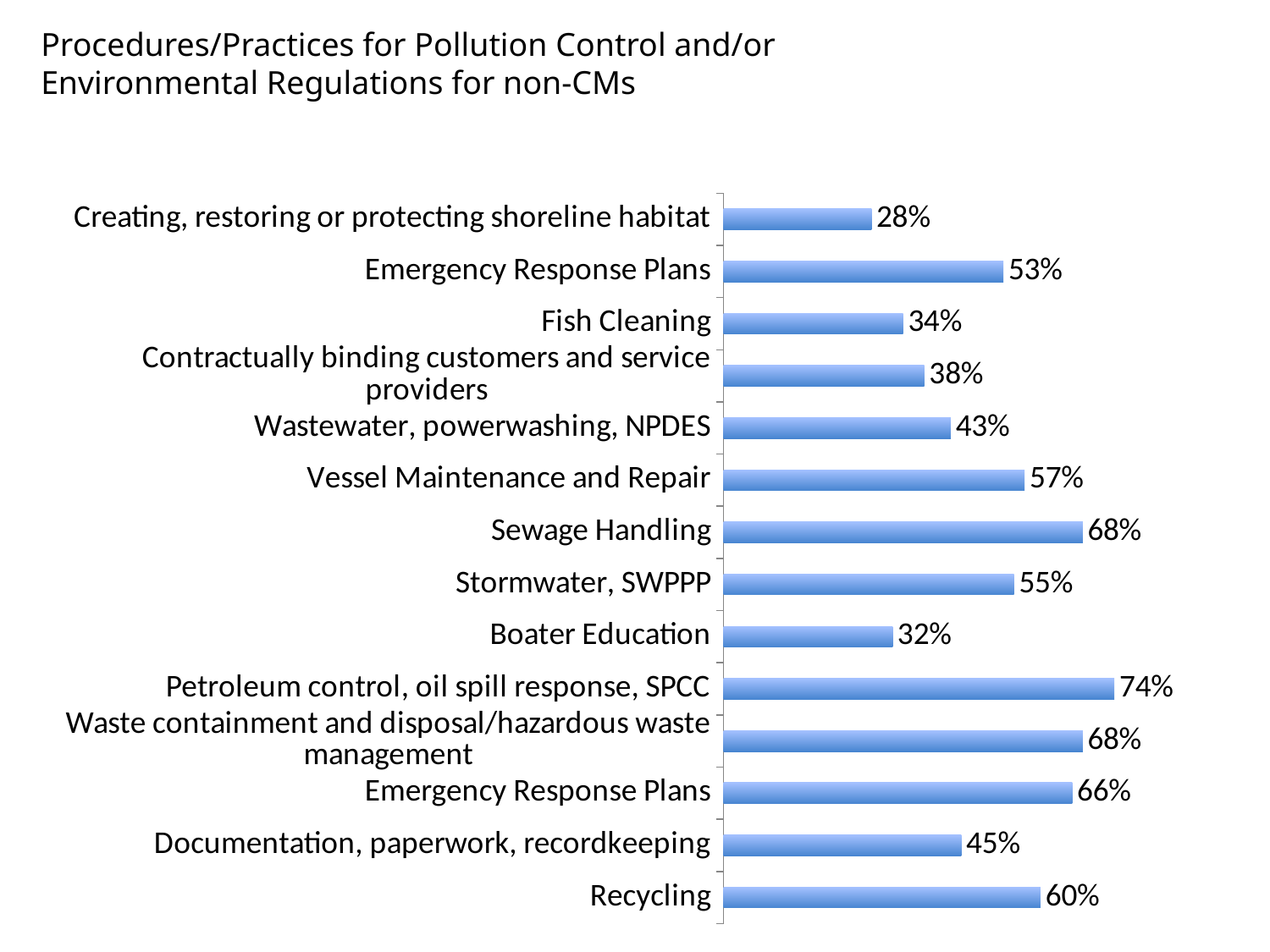
What is the value for Fish Cleaning? 34% What is the value for Recycling? 60% What kind of chart is shown on the slide? Bar chart What is the value for Documentation, paperwork, recordkeeping? 45% What is the difference between the values for Petroleum control, oil spill response, SPCC and Contractually binding customers and service providers? 36% What is the value for Sewage Handling? 68% What is the difference between the values for Vessel Maintenance and Repair and Boater Education? 25% What is the title of the chart? Procedures/Practices for Pollution Control and/or Environmental Regulations for non-CMs Which is larger, the value for Stormwater, SWPPP or the value for Wastewater, powerwashing, NPDES? Stormwater, SWPPP Which category has the highest value? Petroleum control, oil spill response, SPCC Which category has the lowest value? Creating, restoring or protecting shoreline habitat How many categories are shown in the chart? 14